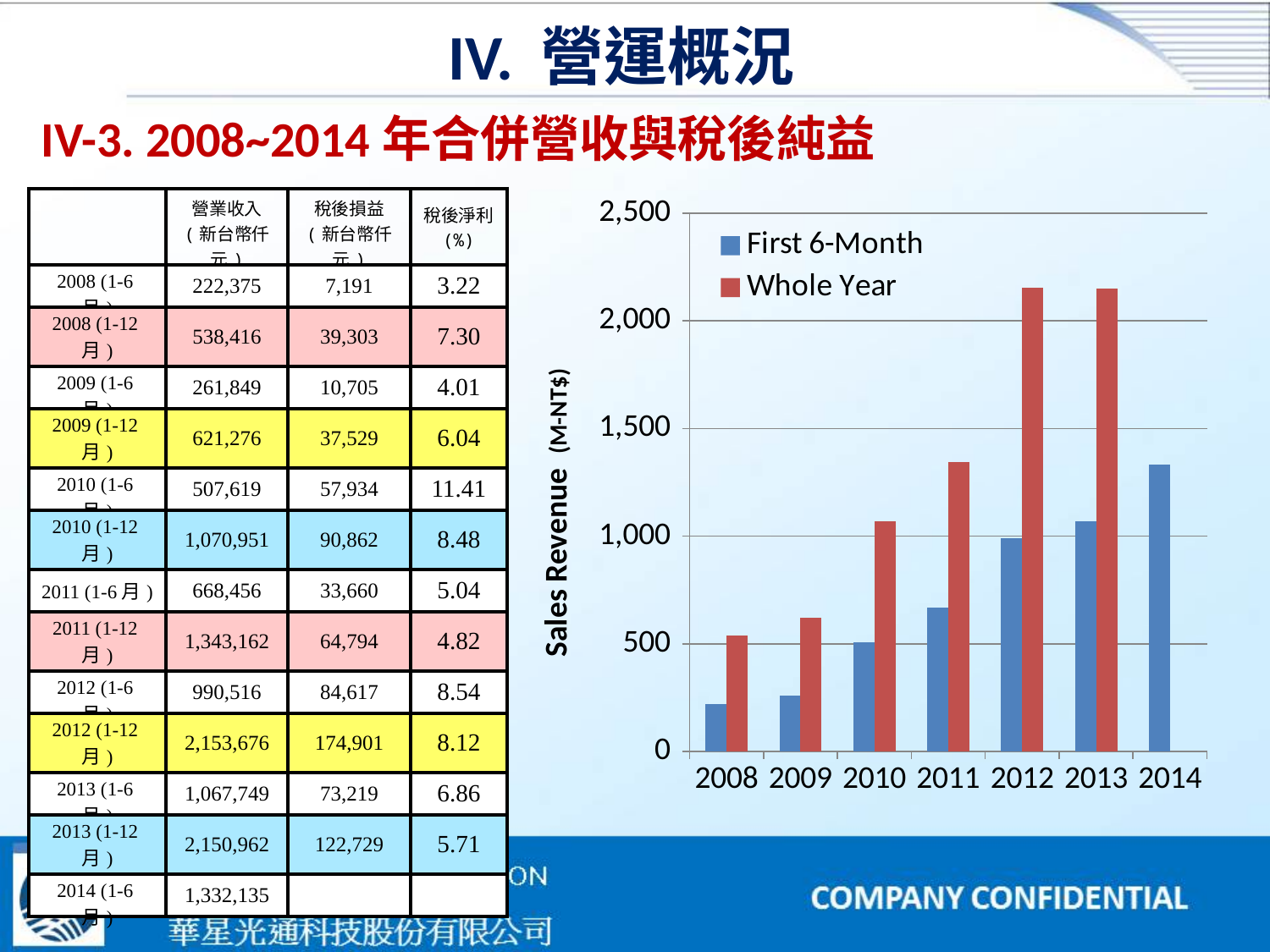
How many series does the chart legend list? 2 Which year has the lowest First 6-Month bar? 2008 What is the title of the chart's vertical axis? Sales Revenue (M-NT$) Which year has the lowest Whole Year bar? 2008 Is the First 6-Month value for 2008 greater or less than 500? less Is the Whole Year value for 2012 greater or less than 2,000? greater Is the Whole Year value for 2011 greater or less than 1,000? greater Which is larger, the First 6-Month value for 2010 or the First 6-Month value for 2009? 2010 Do the Whole Year values rise or fall from 2008 to 2012? rise Which year has the highest First 6-Month bar? 2014 What kind of chart is shown on the slide? bar chart How many years are shown on the x axis of the chart? 7